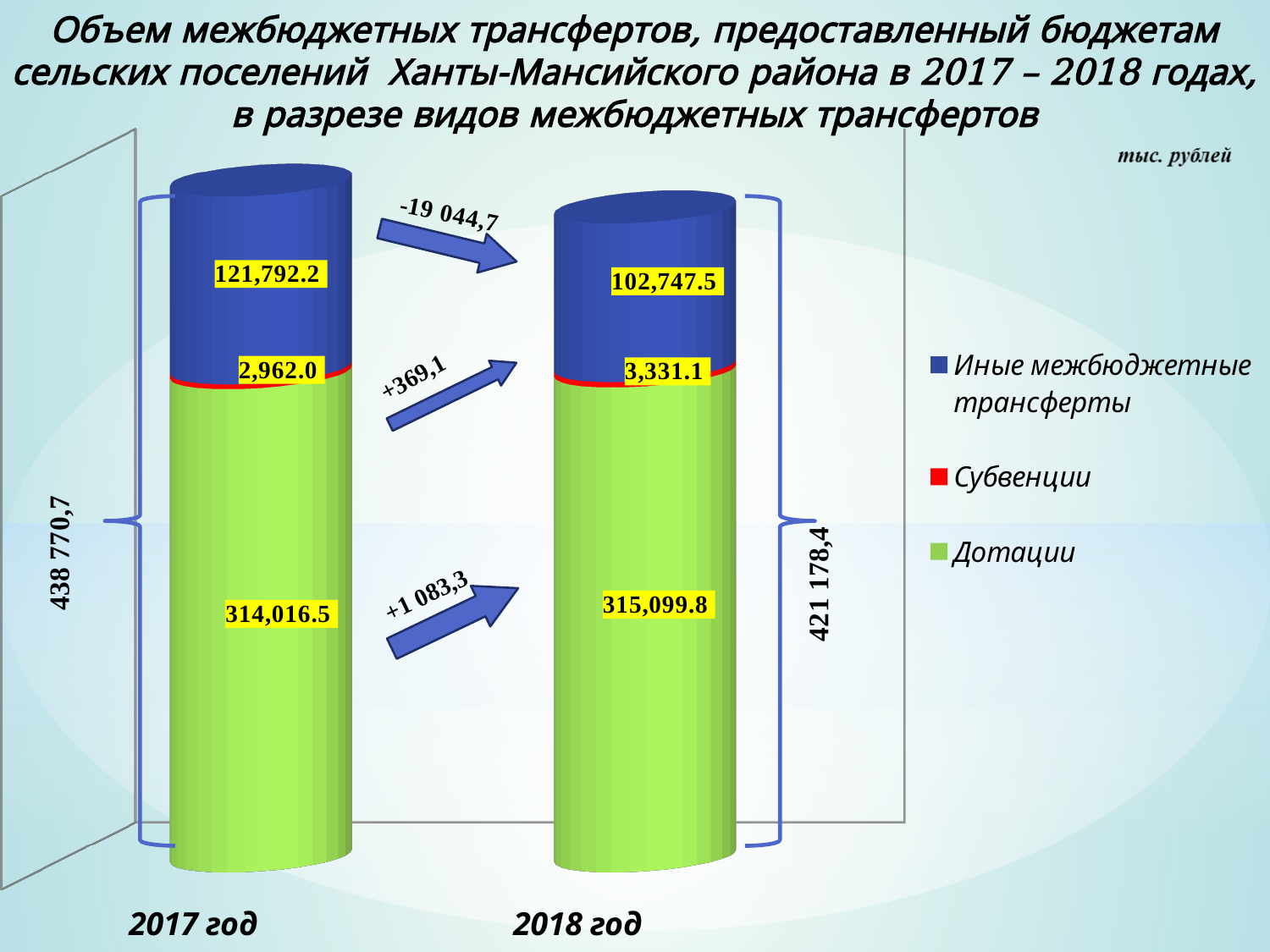
Which series has the largest value in 2017 год? Дотации What is the value of Субвенции for 2018 год? 3,331.1 What is the value of Иные межбюджетные трансферты for 2018 год? 102,747.5 How many series does the legend list? 3 What is the total of the stacked bar for 2017 год? 438 770,7 What is the total of the stacked bar for 2018 год? 421 178,4 By how much did Иные межбюджетные трансферты change from 2017 год to 2018 год, as shown on the arrow? -19 044,7 What is the value of Субвенции for 2017 год? 2,962.0 What is the value of Дотации for 2017 год? 314,016.5 What kind of chart is shown on the slide? Stacked bar chart Is the value of Иные межбюджетные трансферты larger in 2017 год or in 2018 год? 2017 год Which series has the smallest value in 2018 год? Субвенции